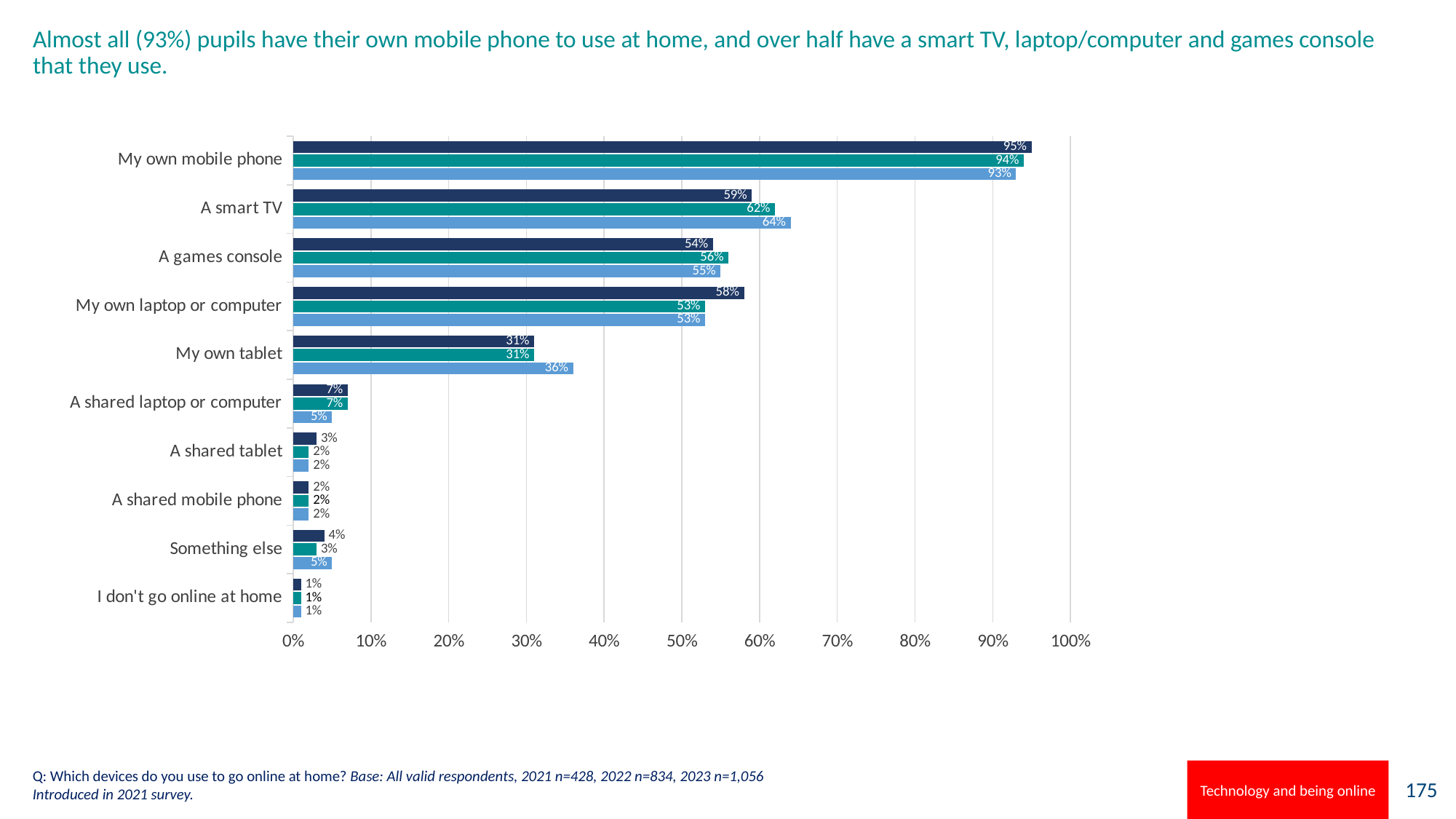
For 'A smart TV', which is larger: the light blue bar or the dark navy bar? The light blue bar (64%) What is the difference between the dark navy bar (58%) and the teal bar (53%) for 'My own laptop or computer'? 5 percentage points What is the value of the dark navy (top) bar for 'A smart TV'? 59% What is the value of the light blue (bottom) bar for 'My own mobile phone'? 93% What is the value of the teal (middle) bar for 'A games console'? 56% Which device category has the lowest values across all three bars? I don't go online at home Which device category has the highest values across all three bars? My own mobile phone Is the light blue bar for 'A shared laptop or computer' greater or less than 10%? less What kind of chart is shown on the slide? Bar chart What is the value of the light blue (bottom) bar for 'My own tablet'? 36% How many device categories are listed on the chart? 10 What is the value of the dark navy (top) bar for 'Something else'? 4%